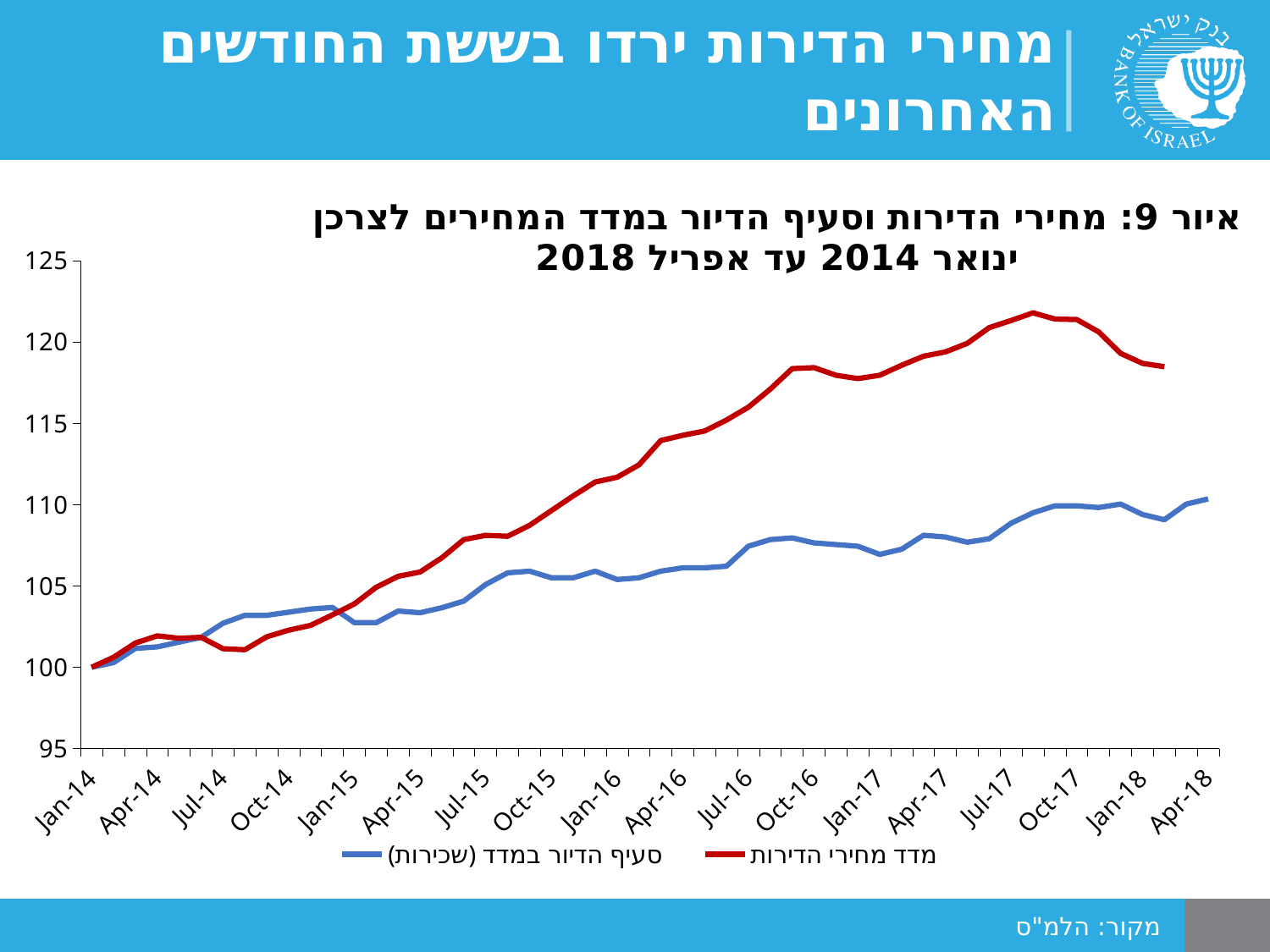
Is the value of מדד מחירי הדירות (red line) at Jul-17 greater or less than 120? greater How many series does the legend list? 2 Does the red line (מדד מחירי הדירות) rise or fall over the last months of the chart, from late 2017 to Apr-18? fall Is the value of מדד מחירי הדירות (red line) at Jan-15 greater or less than 105? less Is the value of סעיף הדיור במדד (שכירות) (blue line) at Apr-18 greater or less than 105? greater What type of chart is shown on the slide? line chart What is the value of both series at Jan-14, where the lines start? 100 Which colour is used for the series מדד מחירי הדירות? red Does the blue line (סעיף הדיור במדד (שכירות)) generally rise or fall from Jan-14 to Apr-18? rise